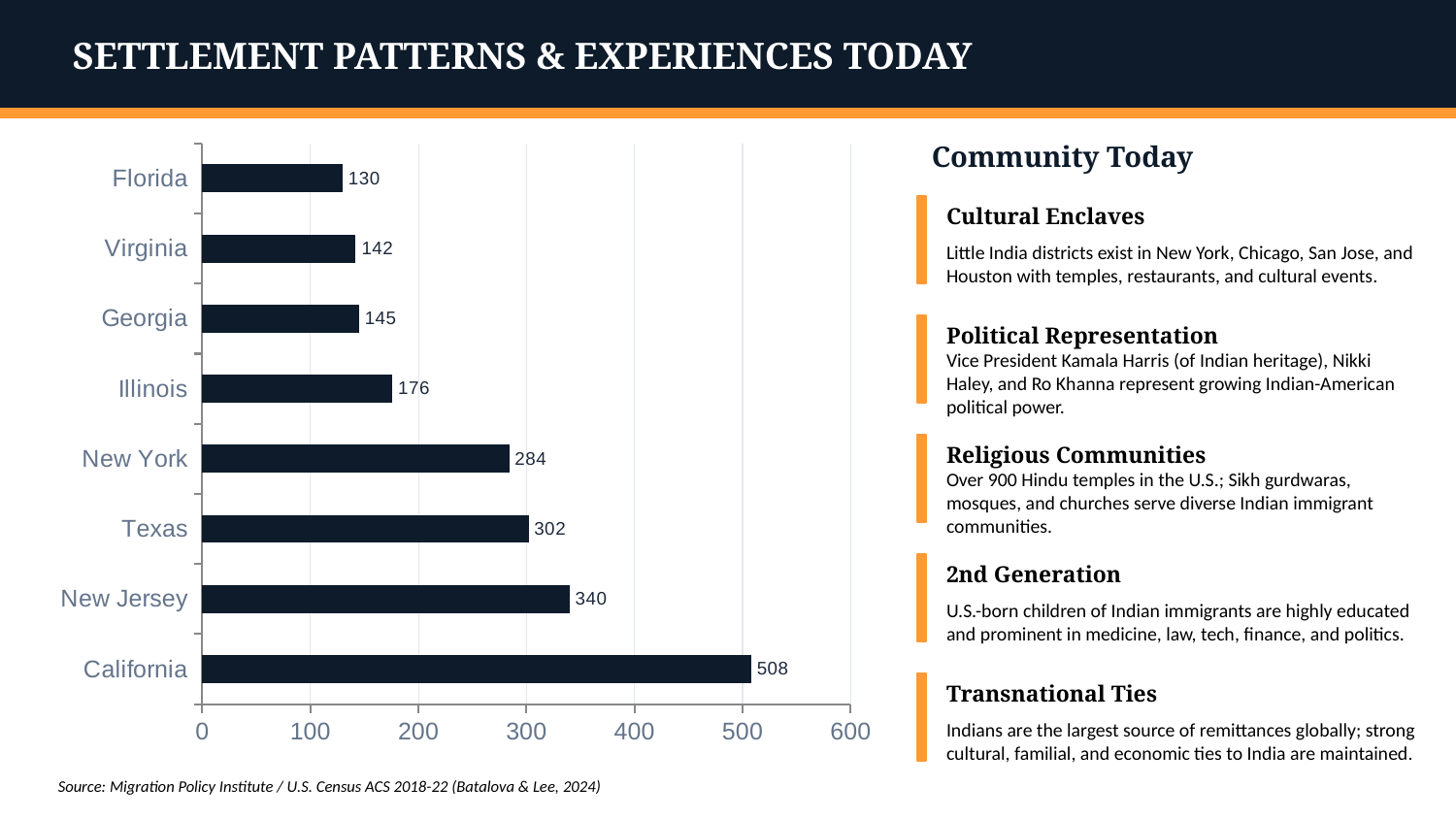
What is the difference between the values for Texas and New York? 18 Which is larger, the value for Texas or the value for New York? Texas What is the value for Illinois? 176 Which state has the highest value? California What is the source cited below the chart? Migration Policy Institute / U.S. Census ACS 2018-22 (Batalova & Lee, 2024) What is the difference between the values for California and New Jersey? 168 What kind of chart is shown on the slide? Bar chart What is the value for New Jersey? 340 Which state has the lowest value? Florida Is the value for New Jersey greater or less than 300? greater What is the value for California? 508 How many states are shown in the chart? 8